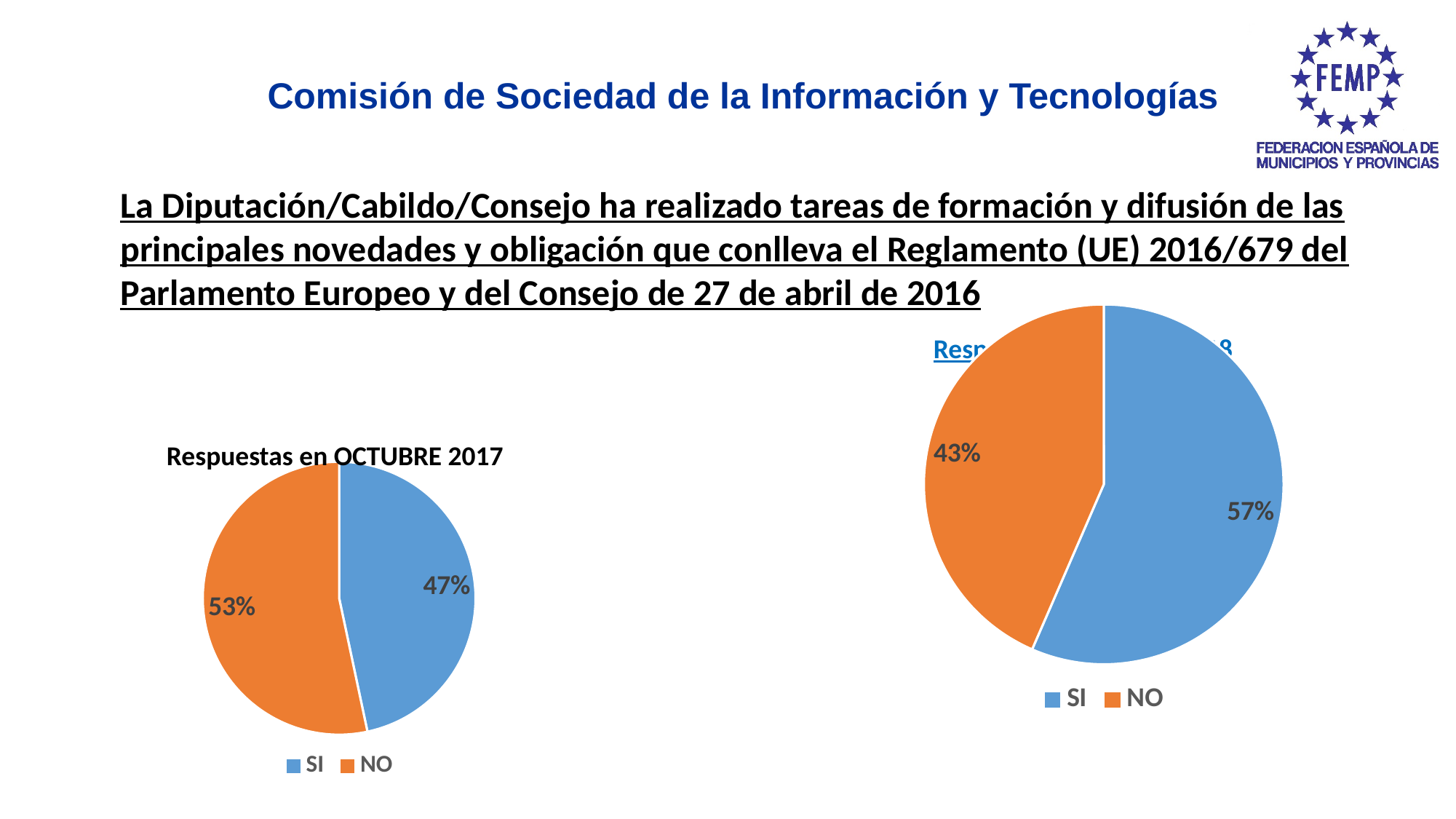
In the pie chart titled "Respuestas en OCTUBRE 2017", which category has the larger share? NO In the pie chart on the right side of the slide, what is the difference in percentage points between SI and NO? 14 In the pie chart titled "Respuestas en OCTUBRE 2017", what percentage is shown for SI? 47% What type of chart is the chart titled "Respuestas en OCTUBRE 2017"? Pie chart In the pie chart titled "Respuestas en OCTUBRE 2017", what colour is the SI slice? Blue In the pie chart on the right side of the slide, which category has the smaller share? NO In the pie chart titled "Respuestas en OCTUBRE 2017", what is the difference in percentage points between NO and SI? 6 In the pie chart titled "Respuestas en OCTUBRE 2017", what percentage is shown for NO? 53% In the pie chart on the right side of the slide, which category has the larger share? SI In the pie chart on the right side of the slide, what percentage is shown for SI? 57% How many categories does the legend of the pie chart on the right side of the slide list? 2 In the pie chart on the right side of the slide, what percentage is shown for NO? 43%